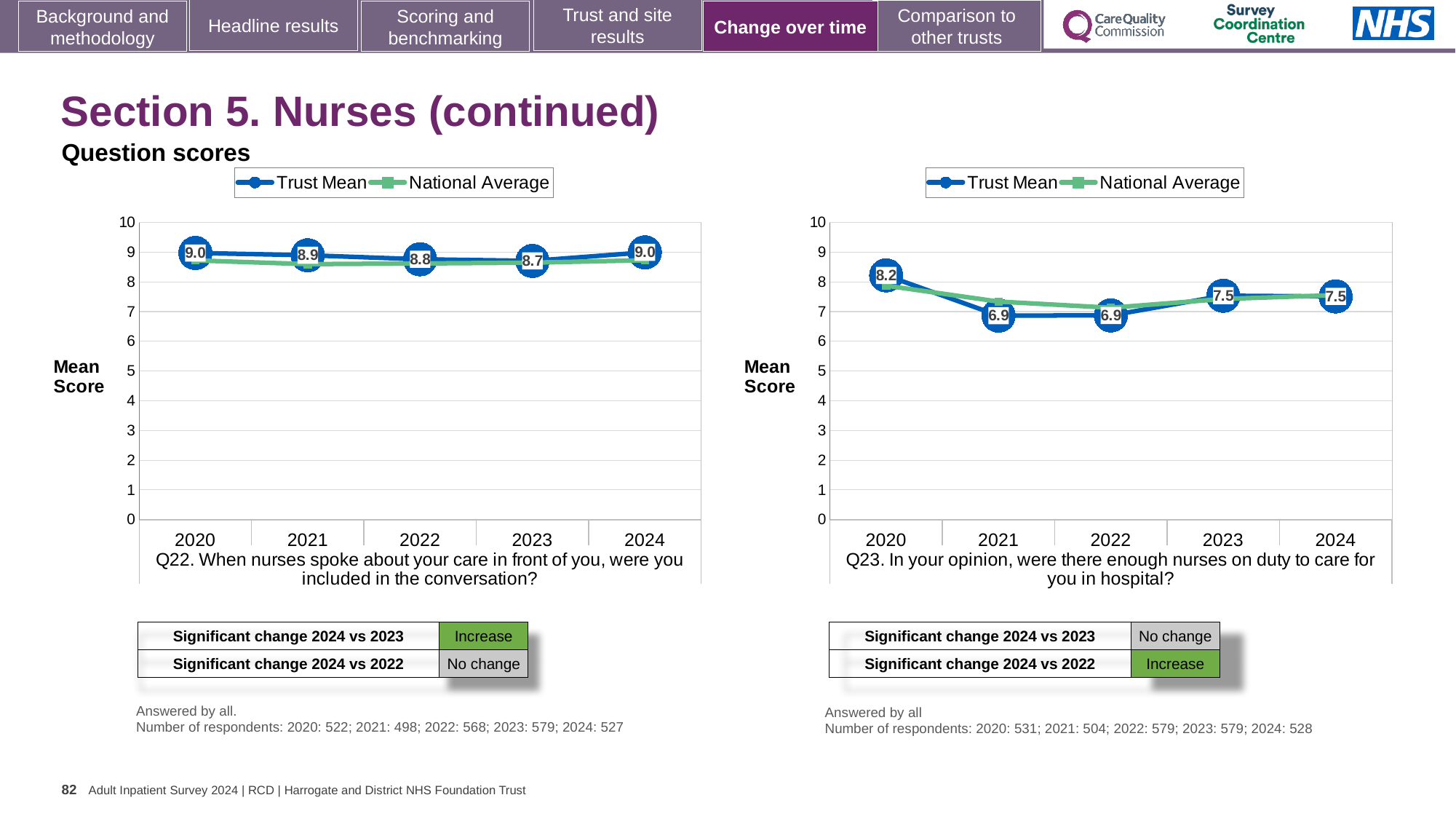
How many series does the legend of the Q22 chart list? 2 On the Q23 chart, what is the difference between the Trust Mean scores for 2020 and 2021? 1.3 On the Q22 chart, what is the Trust Mean score for 2020? 9.0 On the Q23 chart, is the Trust Mean score for 2020 larger or smaller than the Trust Mean score for 2023? larger On the Q22 chart, which year has the lowest Trust Mean score? 2023 On the Q22 chart, what is the Trust Mean score for 2023? 8.7 On the Q22 chart, what is the difference between the Trust Mean scores for 2024 and 2023? 0.3 On the Q23 chart, what is the Trust Mean score for 2020? 8.2 On the Q23 chart, which year has the highest Trust Mean score? 2020 What kind of chart is the Q23 chart? line chart On the Q23 chart, is the National Average for 2021 greater or less than 8? less On the Q23 chart, what is the Trust Mean score for 2024? 7.5